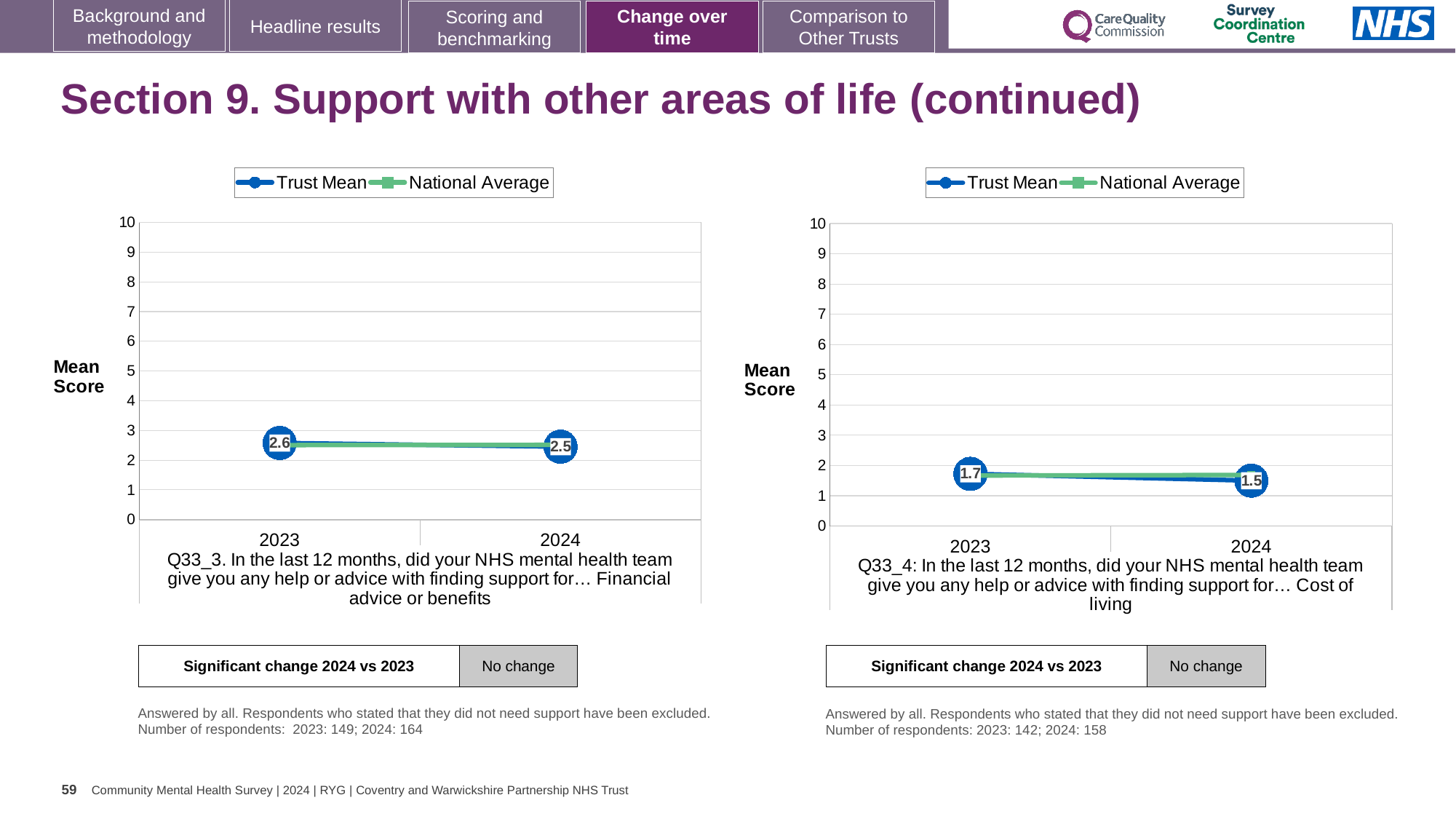
On the left chart (Q33_3, Financial advice or benefits), what is the Trust Mean score for 2023? 2.6 On the right chart (Q33_4), does the Trust Mean rise or fall from 2023 to 2024? fall On the right chart (Q33_4), is the National Average value for 2024 greater or less than 5? less On the right chart (Q33_4, Cost of living), what is the Trust Mean score for 2023? 1.7 On the right chart (Q33_4), what is the difference between the Trust Mean for 2023 and 2024? 0.2 What kind of chart is the right chart (Q33_4)? line chart On the left chart (Q33_3, Financial advice or benefits), what is the Trust Mean score for 2024? 2.5 How many series does the legend of the left chart list? 2 How many years are plotted on the x axis of the left chart? 2 On the left chart (Q33_3), by how much did the Trust Mean change from 2023 to 2024? 0.1 On the left chart (Q33_3), which year has the higher Trust Mean, 2023 or 2024? 2023 On the right chart (Q33_4, Cost of living), what is the Trust Mean score for 2024? 1.5